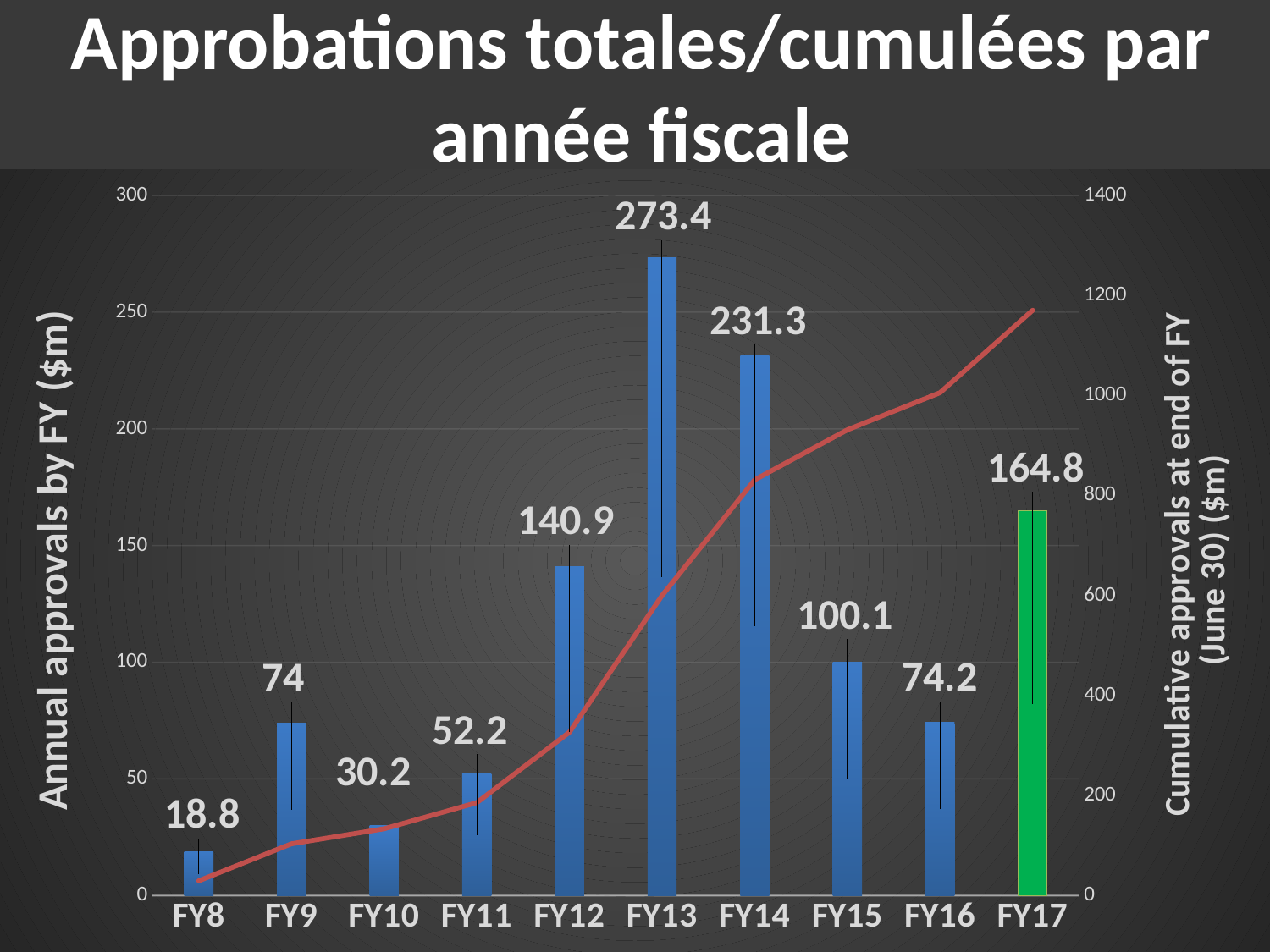
What is the annual approvals value for FY8? 18.8 Which fiscal year has the lowest annual approvals? FY8 What kind of chart is shown on the slide? bar chart with a line Which fiscal year's bar is coloured green instead of blue? FY17 What is the annual approvals value for FY13? 273.4 Is the cumulative approvals value (red line) at FY17 greater or less than 1000? greater Which has higher annual approvals, FY12 or FY15? FY12 Which fiscal year has the highest annual approvals? FY13 How many fiscal years are shown on the x axis? 10 What is the difference between the annual approvals for FY13 and FY14? 42.1 What is the difference between the annual approvals for FY17 and FY16? 90.6 What is the annual approvals value for FY17? 164.8